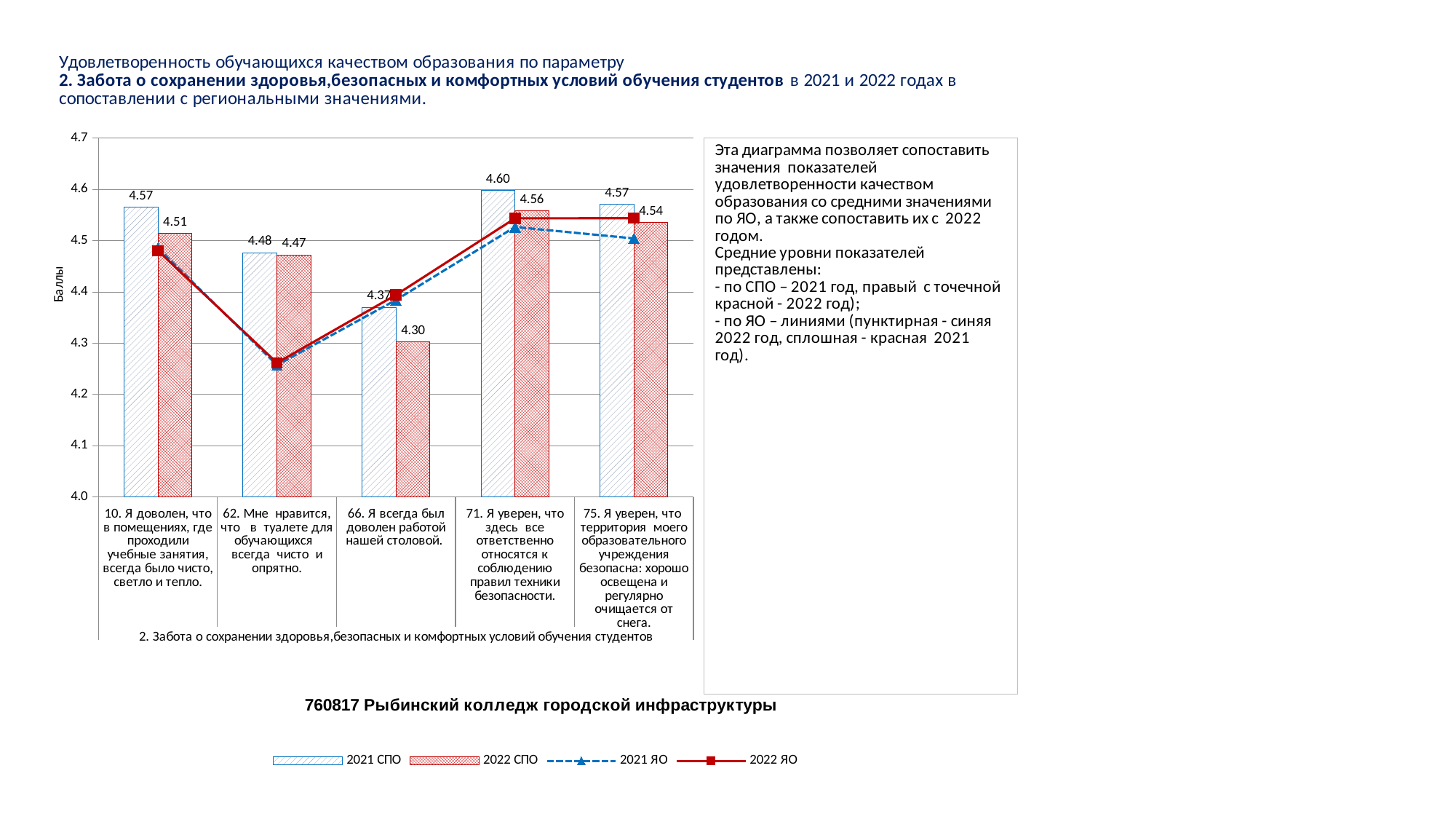
What kind of chart is this? Combined bar and line chart Which is larger for item 62 (туалет): the 2021 СПО value or the 2022 СПО value? 2021 СПО What is the label of the vertical axis? Баллы Which item has the highest 2021 СПО value? 71. Я уверен, что здесь все ответственно относятся к соблюдению правил техники безопасности. What is the 2021 СПО value for item 10 (Я доволен, что в помещениях, где проходили учебные занятия, всегда было чисто, светло и тепло)? 4.57 How many items (categories) are shown on the x axis? 5 What is the 2022 СПО value for item 66 (Я всегда был доволен работой нашей столовой)? 4.30 How many series does the legend list? 4 Is the 2022 ЯО value for item 62 (туалет) greater or less than 4.3? less Which item has the lowest 2022 СПО value? 66. Я всегда был доволен работой нашей столовой. What is the difference between the 2021 СПО and 2022 СПО values for item 66 (столовая)? 0.07 What is the 2022 СПО value for item 71 (Я уверен, что здесь все ответственно относятся к соблюдению правил техники безопасности)? 4.56